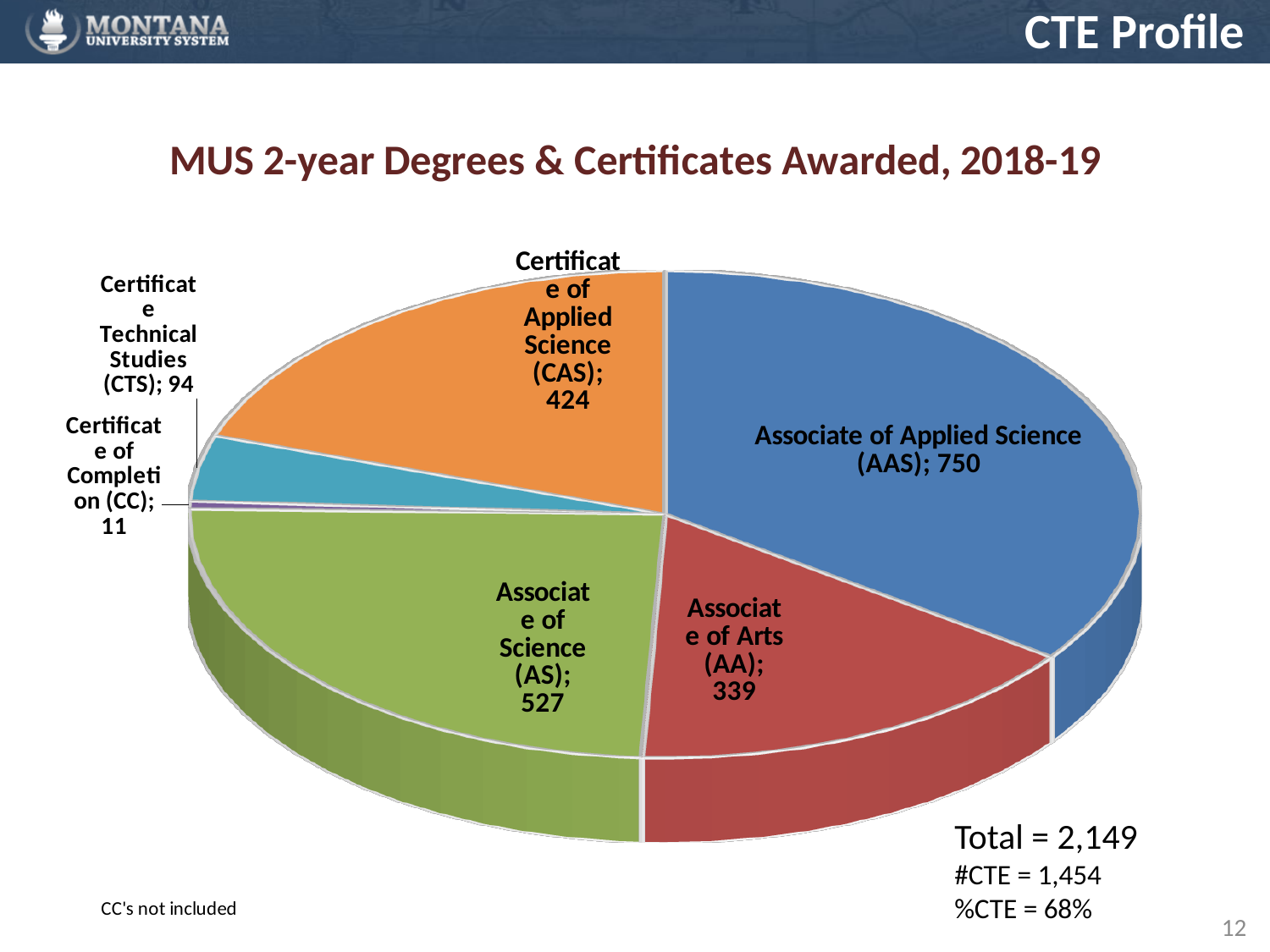
Which category has the smallest slice of the pie? Certificate of Completion (CC) What is the value shown for Certificate of Completion (CC)? 11 What is the value shown for Certificate of Applied Science (CAS)? 424 What is the value shown for Associate of Science (AS)? 527 Which is larger, Associate of Science (AS) or Certificate of Applied Science (CAS)? Associate of Science (AS) Which category has the largest slice of the pie? Associate of Applied Science (AAS) How many degrees/certificates were awarded for Associate of Applied Science (AAS)? 750 What is the title of the chart? MUS 2-year Degrees & Certificates Awarded, 2018-19 What is the difference between the Associate of Arts (AA) value and the Certificate Technical Studies (CTS) value? 245 What type of chart is shown on the slide? Pie chart What is the difference between the Associate of Applied Science (AAS) value and the Associate of Science (AS) value? 223 How many categories are shown in the pie chart? 6